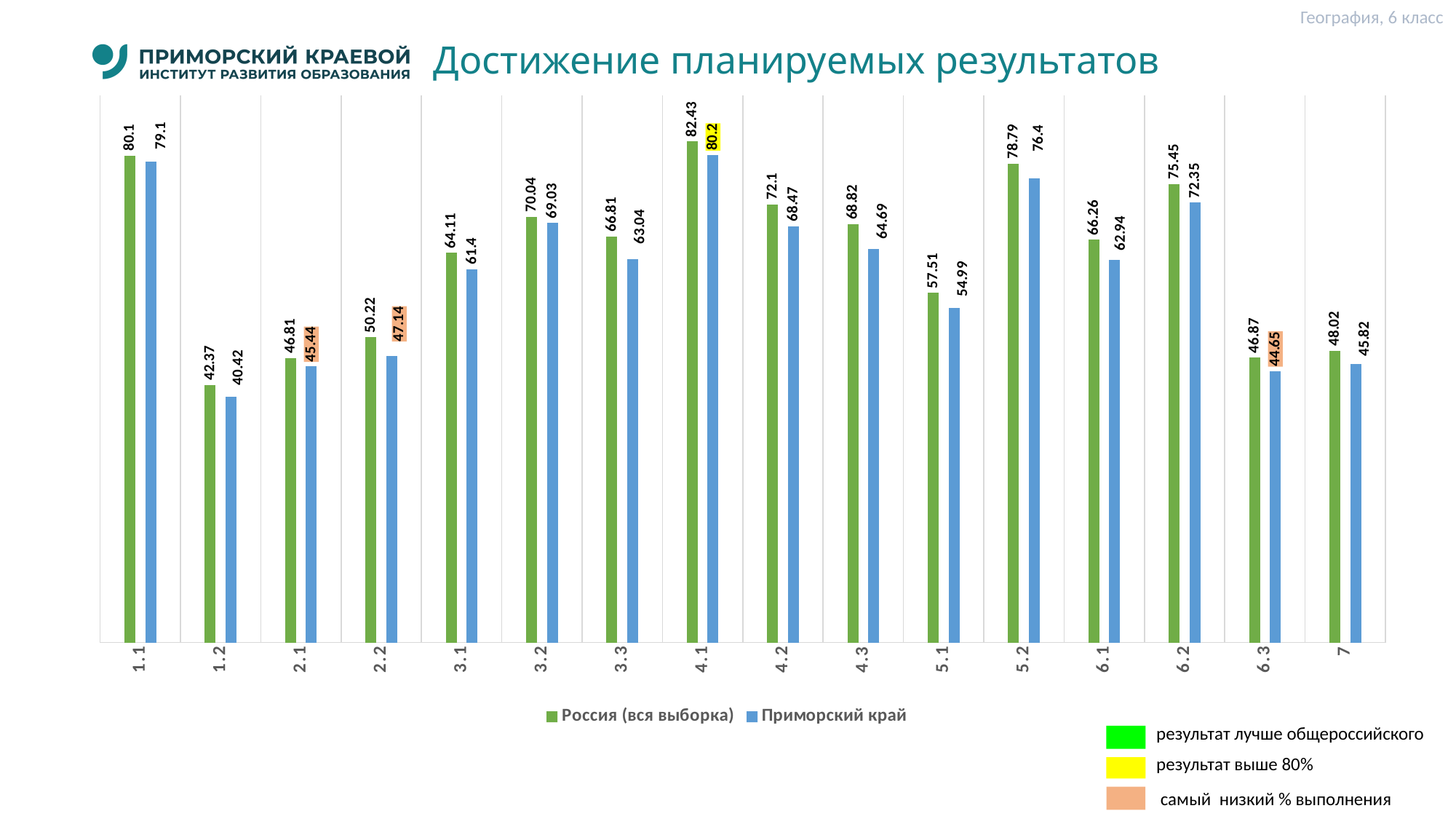
Which category has the highest value for Россия (вся выборка)? 4.1 What is the value for Россия (вся выборка) for category 3.2? 70.04 What kind of chart is shown on the slide? Bar chart Which category has the lowest value for Приморский край? 1.2 What is the value for Приморский край for category 4.1? 80.2 How many series does the legend list? 2 What is the value for Приморский край for category 6.3? 44.65 What is the title of the slide's chart? Достижение планируемых результатов What is the difference between the Россия (вся выборка) and Приморский край values for category 5.2? 2.39 Which series is shown in blue in the legend? Приморский край How many categories are shown on the x axis? 16 Which is larger for category 2.2: the value for Россия (вся выборка) or for Приморский край? Россия (вся выборка)